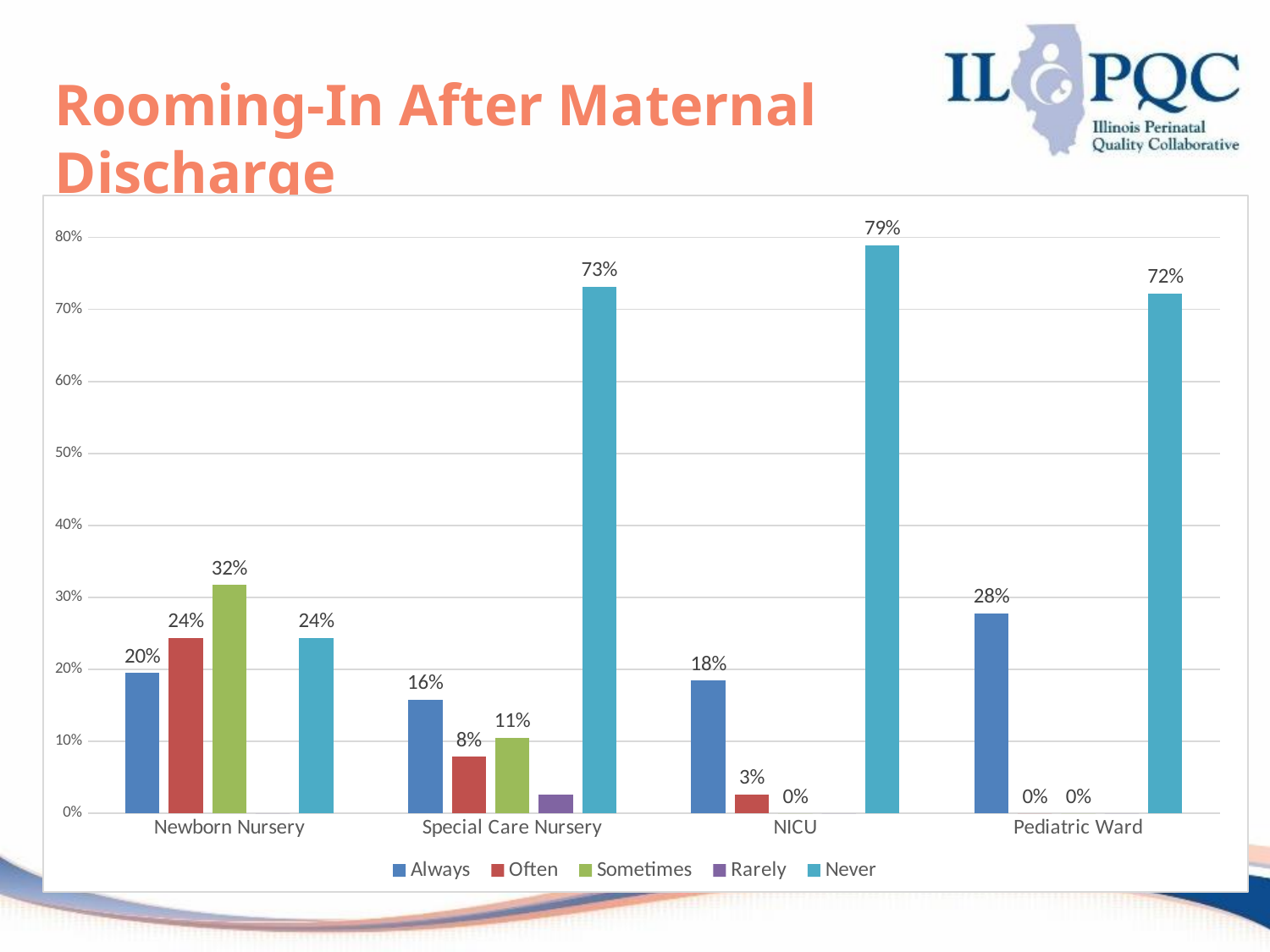
Which category has the lowest value for Always? Special Care Nursery What is the difference between the Never value for NICU and the Never value for Pediatric Ward? 7% Which is larger: the Always value for Newborn Nursery or the Always value for NICU? Newborn Nursery What is the title of the slide? Rooming-In After Maternal Discharge How many categories are shown on the x axis? 4 Is the value for Never in the Special Care Nursery category greater or less than 70%? greater How many series does the legend list? 5 Which category has the highest value for Never? NICU What is the value for Always in the Pediatric Ward category? 28% What is the value for Never in the NICU category? 79% What is the value for Sometimes in the Newborn Nursery category? 32% What kind of chart is shown on the slide? bar chart